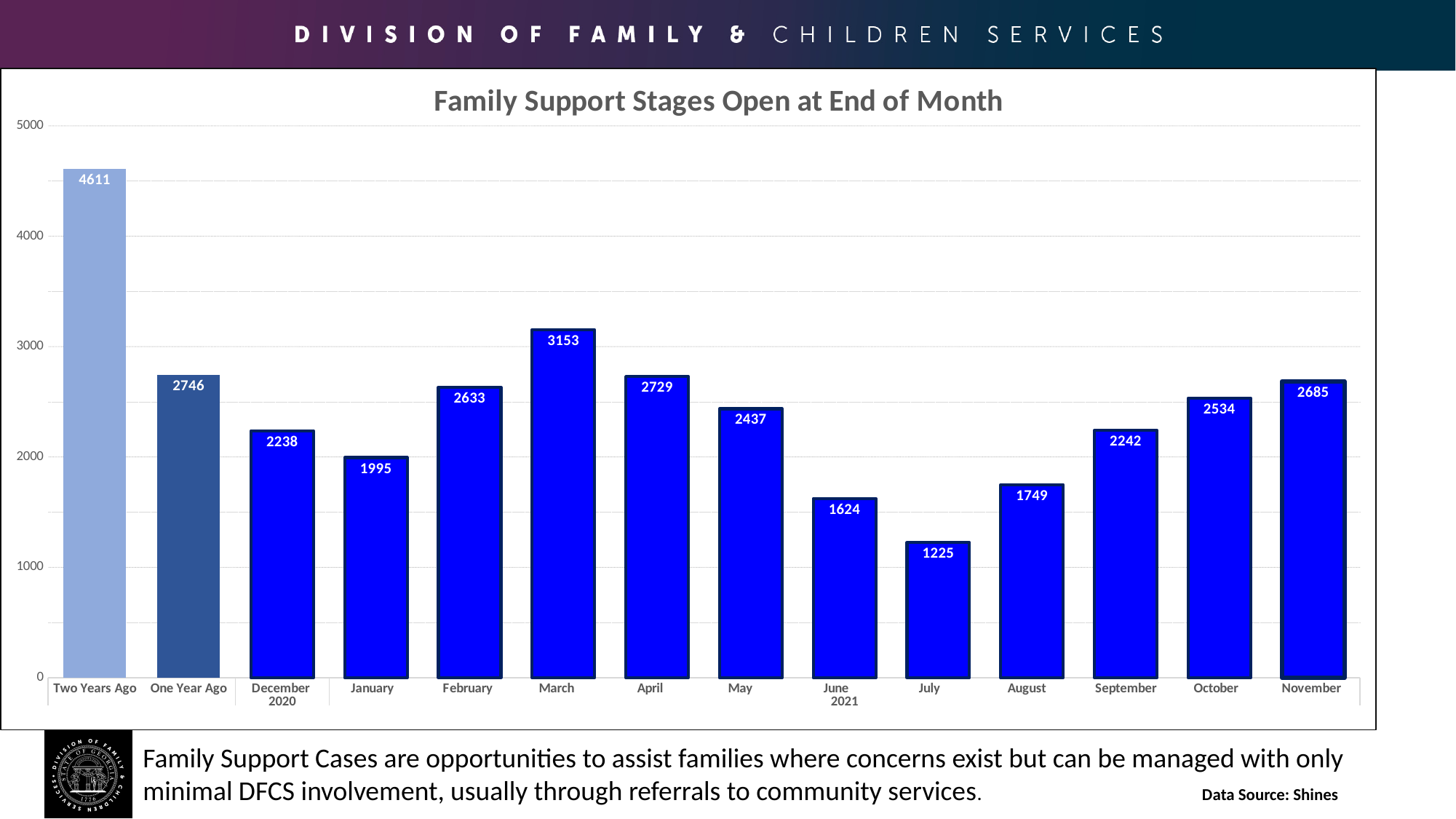
Do the values rise or fall from March to July? Fall Which category has the highest value? Two Years Ago What is the value for Two Years Ago? 4611 Which is larger, the value for February or the value for April? April How many bars are shown in the chart? 14 What is the value for March? 3153 Which category has the lowest value? July What kind of chart is this? Bar chart What is the value for July? 1225 What is the title of the chart? Family Support Stages Open at End of Month Is the value for October greater or less than 2000? greater What is the difference between the values for One Year Ago and November? 61